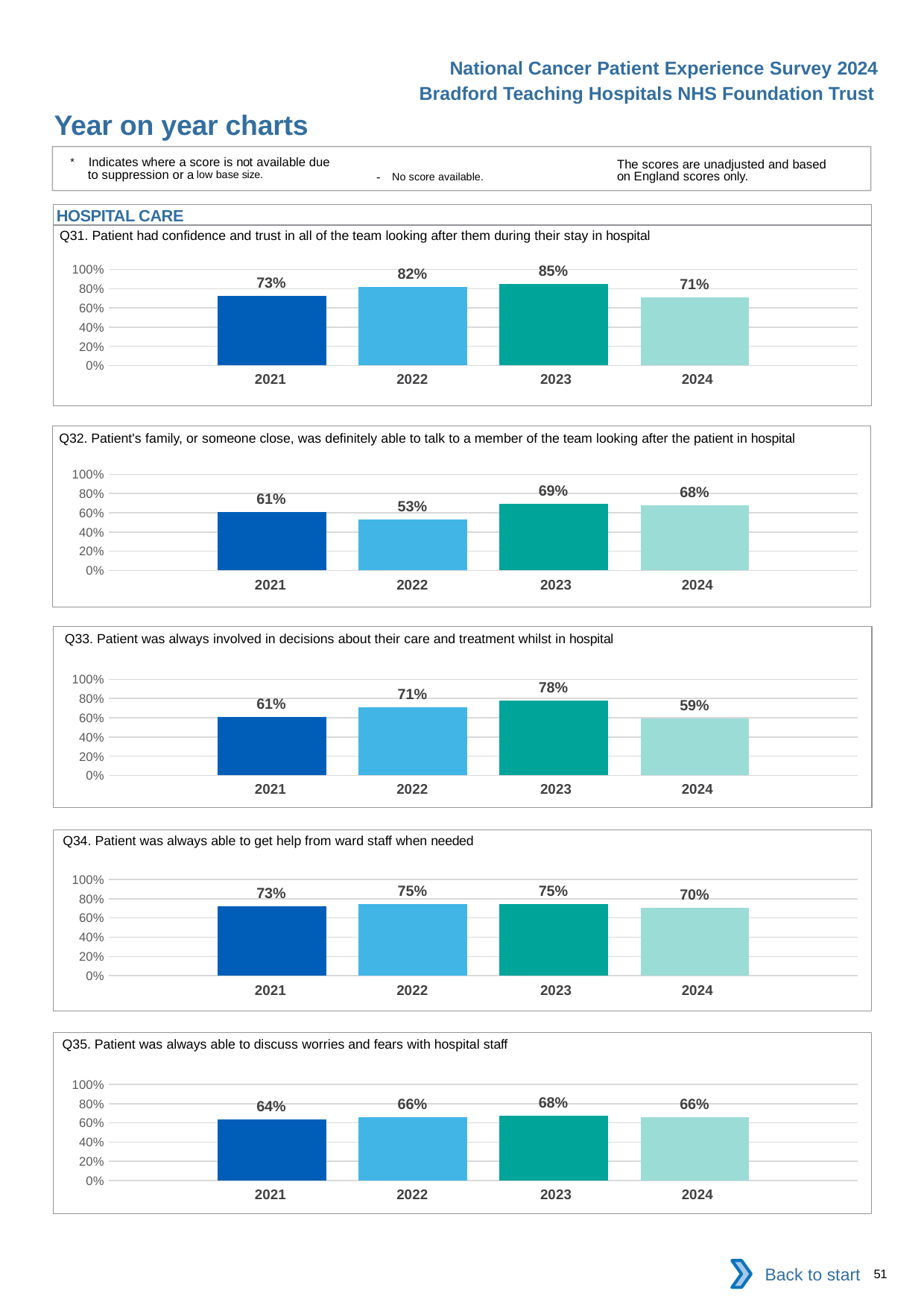
In the Q34 chart, what is the value for 2024? 70% In the Q32 chart, what is the value for 2021? 61% In the Q31 chart, which is larger, the value for 2021 or the value for 2022? 2022 How many years are shown in the Q33 chart? 4 What kind of chart is the Q34 chart? Bar chart In the Q35 chart, which year has the highest value? 2023 In the Q32 chart, which year has the lowest value? 2022 In the Q35 chart, what is the difference between the 2021 and 2022 values? 2 percentage points In the Q31 chart, is the value for 2024 greater or less than 80%? less In the Q33 chart, what is the difference between the 2023 and 2024 values? 19 percentage points In the Q31 chart, what is the value for 2023? 85% How many charts are shown on the slide? 5